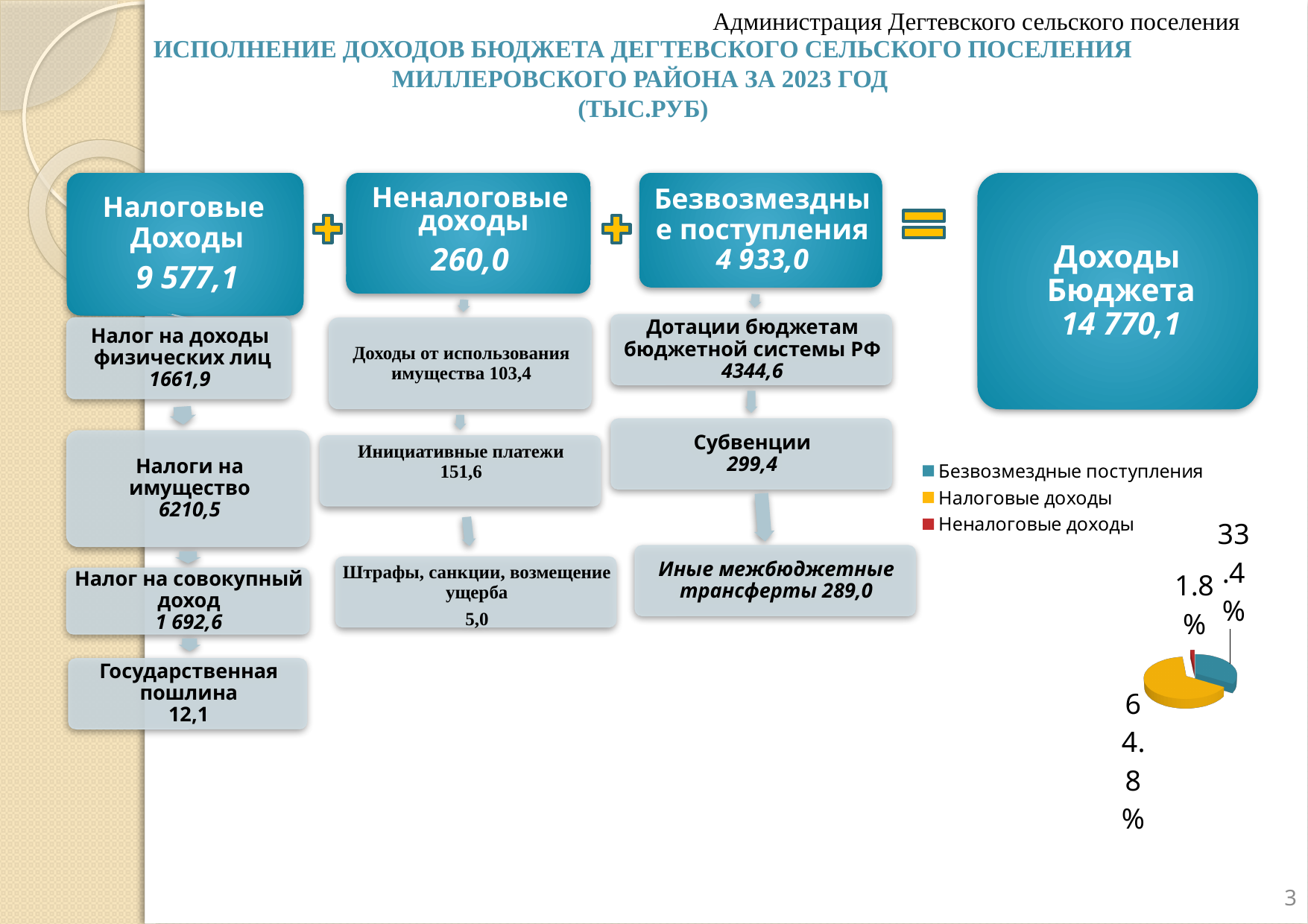
What colour is the Налоговые доходы slice in the pie chart? yellow How many series does the legend of the pie chart list? 3 In the pie chart, what share is shown for Налоговые доходы? 64.8% In the pie chart, what share is shown for Безвозмездные поступления? 33.4% In the pie chart, what is the difference in percentage points between Налоговые доходы and Безвозмездные поступления? 31.4 In the pie chart, which is larger: Безвозмездные поступления or Неналоговые доходы? Безвозмездные поступления Which legend entry in the pie chart is shown in red? Неналоговые доходы In the pie chart, what share is shown for Неналоговые доходы? 1.8% Which slice of the pie chart is the smallest? Неналоговые доходы Which slice of the pie chart is the largest? Налоговые доходы How many slices does the pie chart have? 3 What kind of chart is shown in the lower right of the slide? pie chart